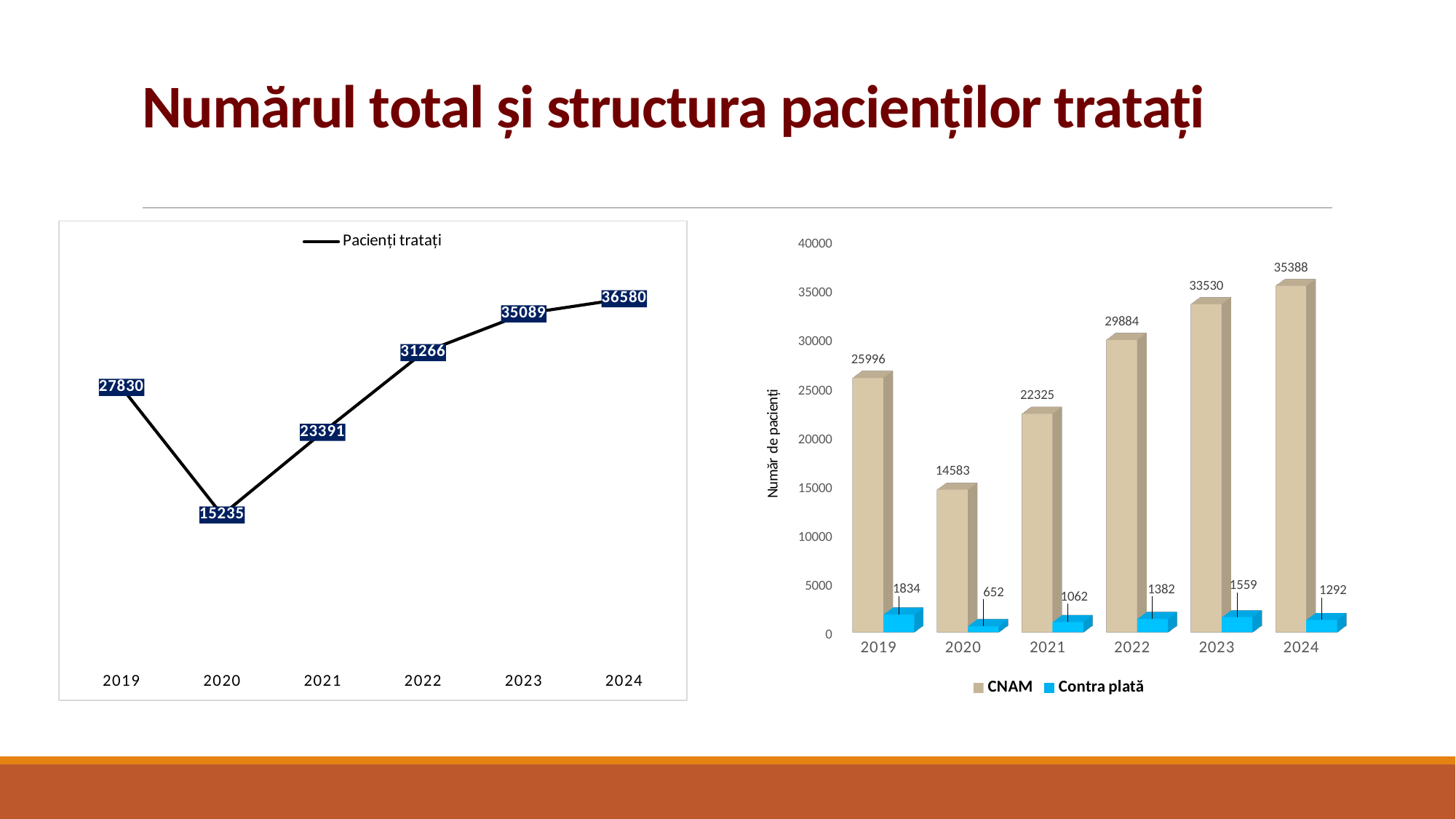
In the bar chart on the right, which year has the highest Contra plată value? 2019 In the line chart on the left, which year has the lowest number of Pacienți tratați? 2020 In the line chart on the left, how many years are plotted? 6 In the line chart on the left, what is the difference between the values for 2024 and 2019? 8750 In the bar chart on the right, what is the Contra plată value for 2020? 652 In the bar chart on the right, how many series does the legend list? 2 In the bar chart on the right, what is the CNAM value for 2022? 29884 What kind of chart is shown on the right side of the slide? bar chart In the line chart on the left, which year has the highest number of Pacienți tratați? 2024 In the line chart on the left, what is the value for Pacienți tratați in 2020? 15235 In the line chart on the left, do the values rise or fall from 2020 to 2024? rise In the bar chart on the right, which is larger: the CNAM value for 2021 or the CNAM value for 2023? 2023